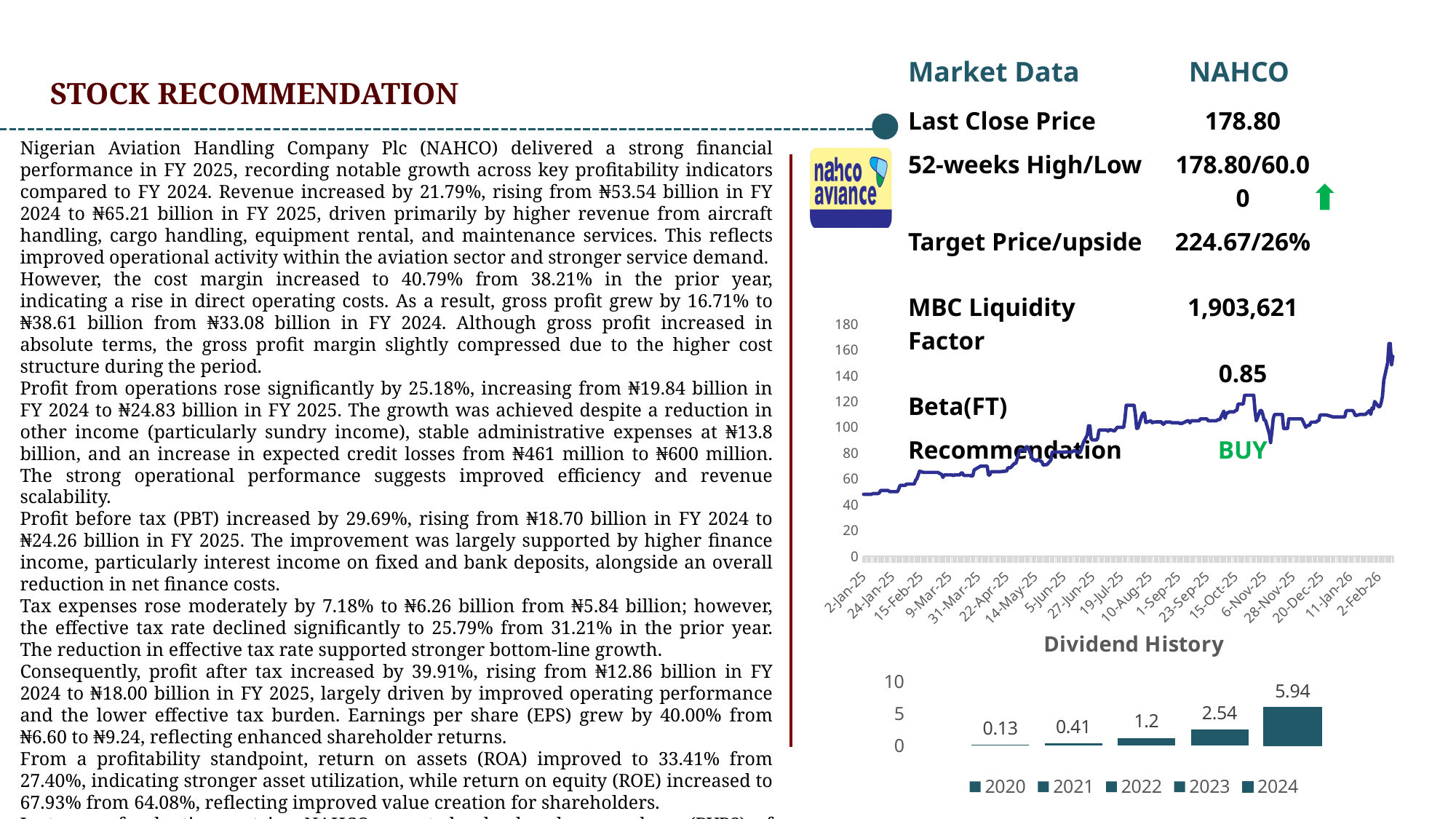
On the Dividend History chart, do the dividend values rise or fall from 2020 to 2024? Rise On the Dividend History chart, what is the dividend value shown for 2020? 0.13 On the Dividend History chart, which year has the lowest dividend? 2020 What kind of chart is the Dividend History chart? Bar chart On the Dividend History chart, which is larger, the dividend for 2022 or for 2021? 2022 On the share price line chart, is the value at 2-Jan-25 greater or less than 60? less On the Dividend History chart, how many entries does the legend list? 5 On the Dividend History chart, what is the dividend value shown for 2024? 5.94 What kind of chart is the share price chart above the Dividend History chart? Line chart On the Dividend History chart, what is the difference between the 2024 and 2023 dividend values? 3.40 On the Dividend History chart, how many years are plotted? 5 On the Dividend History chart, which year has the highest dividend? 2024